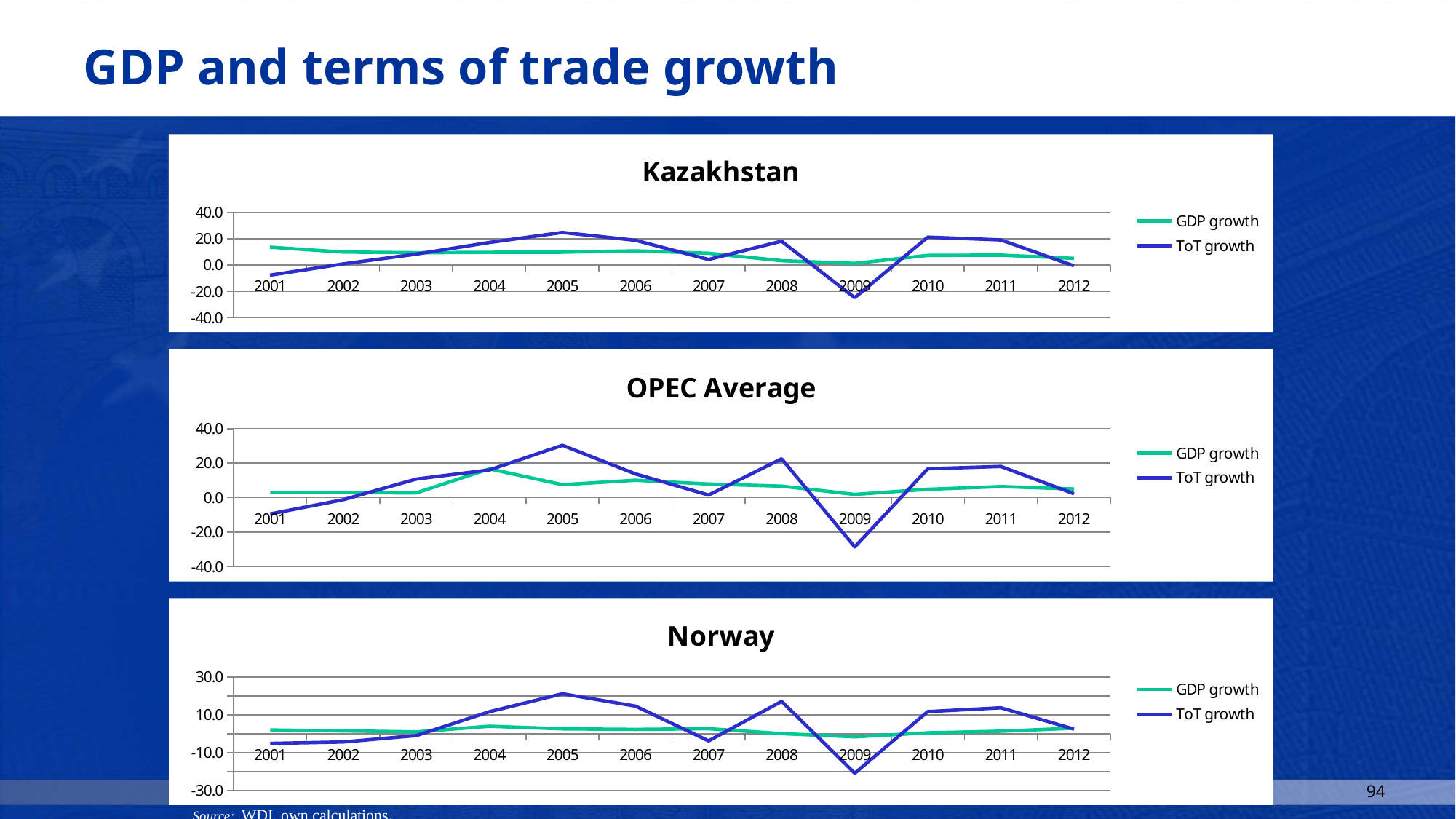
What kind of chart is the Kazakhstan chart? line chart In the OPEC Average chart, in which year is ToT growth highest? 2005 In the Kazakhstan chart, which series has the higher value in 2005, GDP growth or ToT growth? ToT growth What are the titles of the three charts on the slide, from top to bottom? Kazakhstan, OPEC Average, Norway How many years are shown on the x axis of the Norway chart? 12 In the OPEC Average chart, which series has the higher value in 2009, GDP growth or ToT growth? GDP growth In the Kazakhstan chart, is ToT growth in 2009 greater or less than 0.0? less In the Norway chart, is ToT growth in 2009 greater or less than -10.0? less In the OPEC Average chart, is ToT growth in 2005 greater or less than 20.0? greater In the Kazakhstan chart, in which year is ToT growth lowest? 2009 How many series does the legend of the OPEC Average chart list? 2 In the Norway chart, in which year is ToT growth lowest? 2009